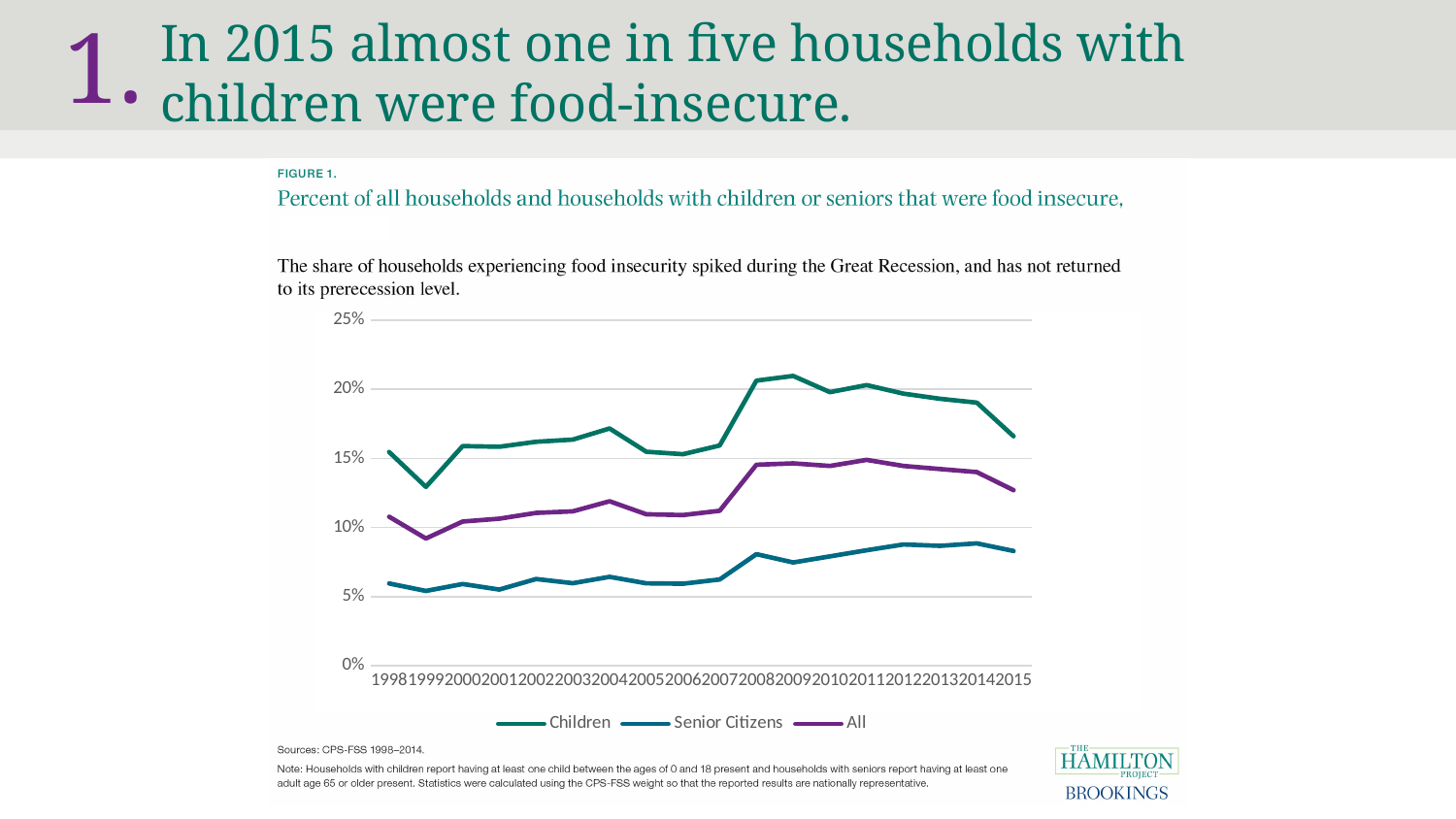
Which series has the lowest values throughout the chart? Senior Citizens In 2010, which is larger: the value for Children or the value for Senior Citizens? Children How many years are plotted along the x axis? 18 Does the Children series rise or fall from 2011 to 2015? fall How many series does the legend list? 3 Which series is drawn in purple? All Which series has the highest values throughout the chart? Children Is the value for Senior Citizens in 2015 greater or less than 10%? less What kind of chart is shown in Figure 1? line chart Is the value for All in 1999 greater or less than 10%? less Is the value for Children in 2009 greater or less than 20%? greater